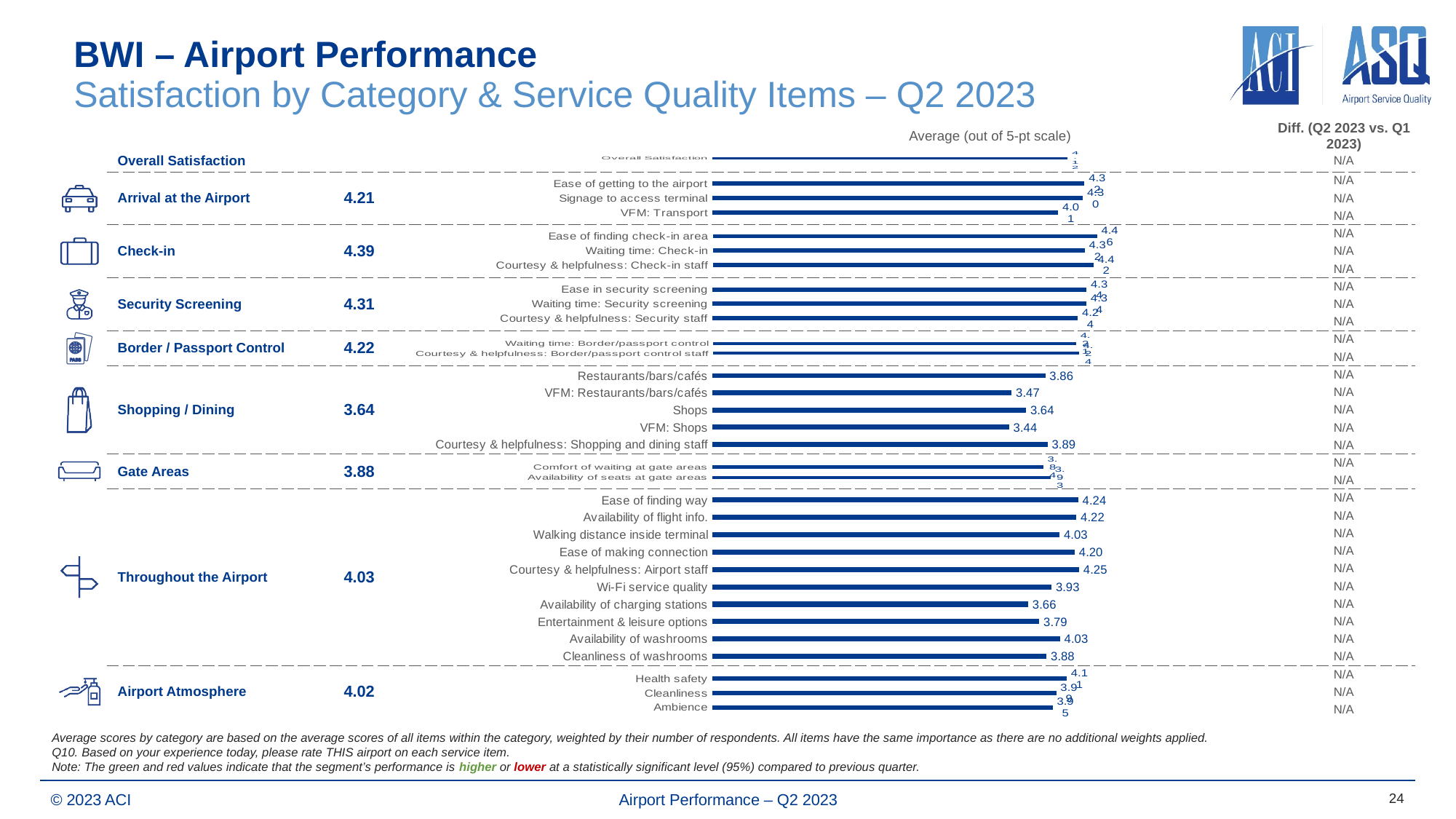
How many items are plotted in the Shopping / Dining chart? 5 In the Shopping / Dining chart, what is the value for VFM: Shops? 3.44 What type of chart is used to show the service quality item scores on this slide? Bar chart In the Throughout the Airport chart, what is the value for Availability of charging stations? 3.66 In the Shopping / Dining chart, which item has the highest value? Courtesy & helpfulness: Shopping and dining staff In the Throughout the Airport chart, which item has the highest value? Courtesy & helpfulness: Airport staff In the Throughout the Airport chart, what is the value for Wi-Fi service quality? 3.93 In the Shopping / Dining chart, what is the value for Restaurants/bars/cafés? 3.86 In the Shopping / Dining chart, what is the difference between Restaurants/bars/cafés and VFM: Restaurants/bars/cafés? 0.39 In the Shopping / Dining chart, which item has the lowest value? VFM: Shops In the Throughout the Airport chart, which is larger: Ease of finding way or Entertainment & leisure options? Ease of finding way In the Throughout the Airport chart, which item has the lowest value? Availability of charging stations